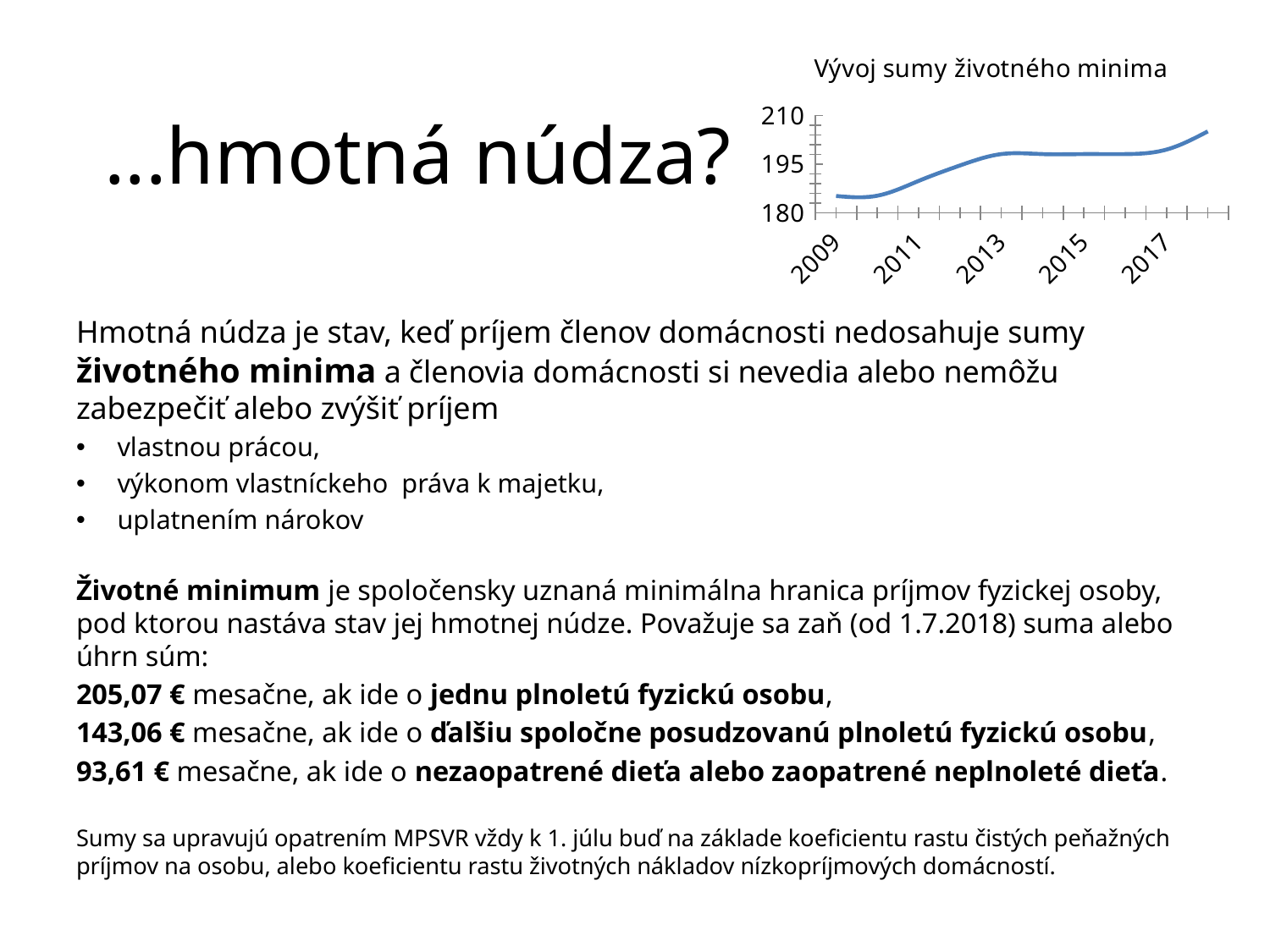
How many year labels are printed on the x axis of the chart? 5 What is the highest value printed on the y axis of the chart? 210 What kind of chart is shown on the slide? line chart What is the title of the chart on the slide? Vývoj sumy životného minima Is the value for 2011 greater or less than 180? greater Is the value at the last point of the line greater or less than 195? greater Is the value for 2017 greater or less than 195? greater Which is larger, the value for 2009 or the value for 2017? 2017 Which year shown on the x axis has the lowest value? 2009 Do the values in the chart generally rise or fall from 2009 to the end of the series? rise